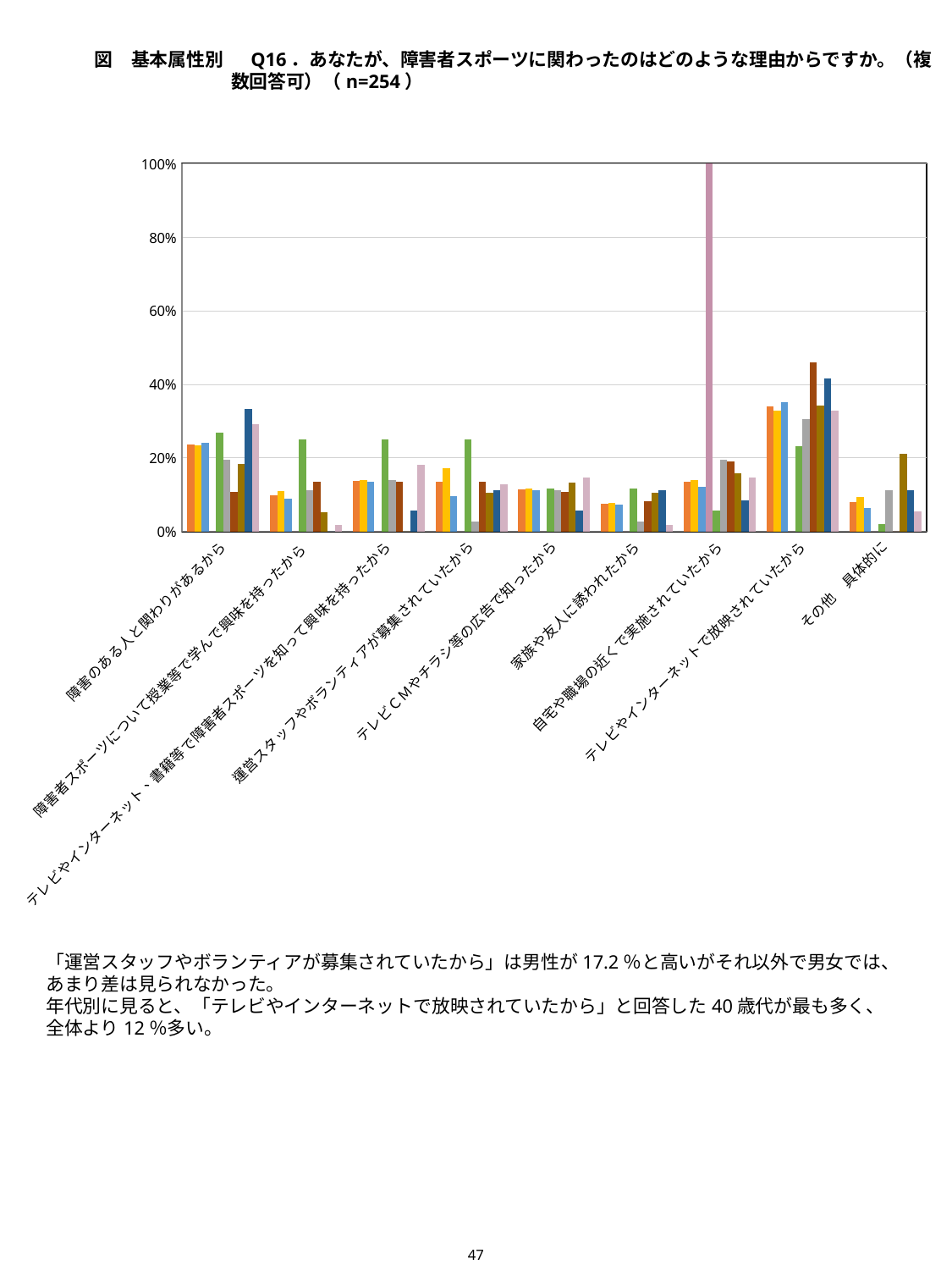
Which group has a taller highest bar: 障害のある人と関わりがあるから or テレビＣＭやチラシ等の広告で知ったから? 障害のある人と関わりがあるから How many categories are shown along the x axis of the chart? 9 Is the tallest bar in the 障害のある人と関わりがあるから group greater or less than 40%? less Is the tallest bar in the 家族や友人に誘われたから group greater or less than 20%? less What is the interval between tick marks on the chart's y axis? 20% Which category contains the tallest bar in the chart? 自宅や職場の近くで実施されていたから What is the maximum value shown on the chart's y axis? 100% Is the tallest bar in the テレビやインターネットで放映されていたから group greater or less than 40%? greater Which group has a taller highest bar: テレビやインターネットで放映されていたから or 家族や友人に誘われたから? テレビやインターネットで放映されていたから What kind of chart is shown on the slide? bar chart